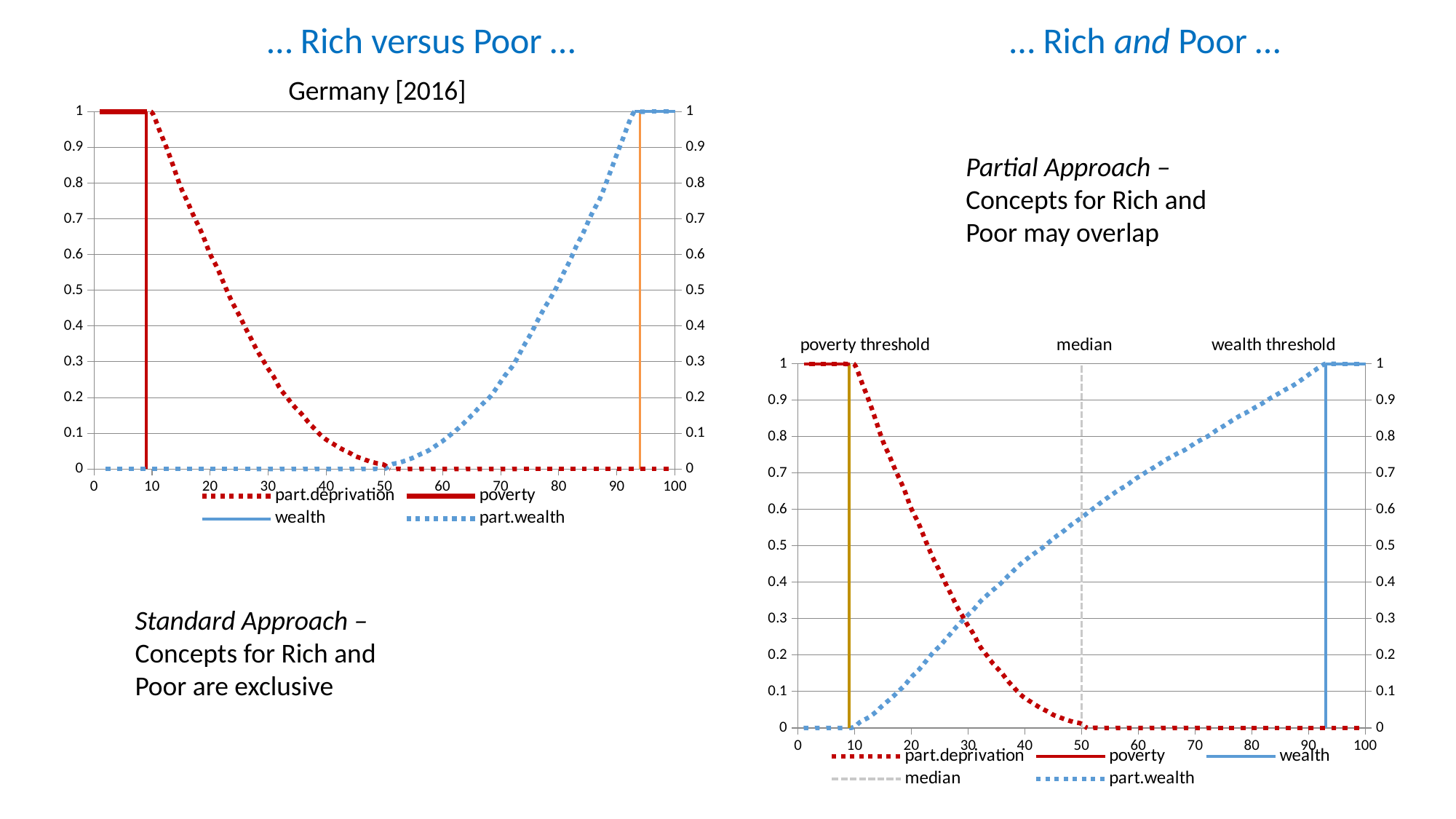
In the left chart (Germany [2016]), does the part.wealth series rise or fall as x increases from 50 to 100? rise In the right chart (under "Rich and Poor"), is the value of part.deprivation at x = 40 greater or less than 0.5? less In the left chart (Germany [2016]), is the value of part.deprivation at x = 20 greater or less than 0.5? greater What is the title of the left chart? Germany [2016] What kind of chart is the left chart titled "Germany [2016]"? line chart How many series does the legend of the right chart (under "Rich and Poor") list? 5 In the right chart, which legend entry is drawn as a grey dashed line? median How many series does the legend of the left chart (Germany [2016]) list? 4 In the right chart (under "Rich and Poor"), at x = 40, which is larger: part.wealth or part.deprivation? part.wealth In the left chart (Germany [2016]), is the value of part.wealth at x = 60 greater or less than 0.5? less In the right chart (under "Rich and Poor"), does the part.deprivation series rise or fall as x increases from 10 to 50? fall